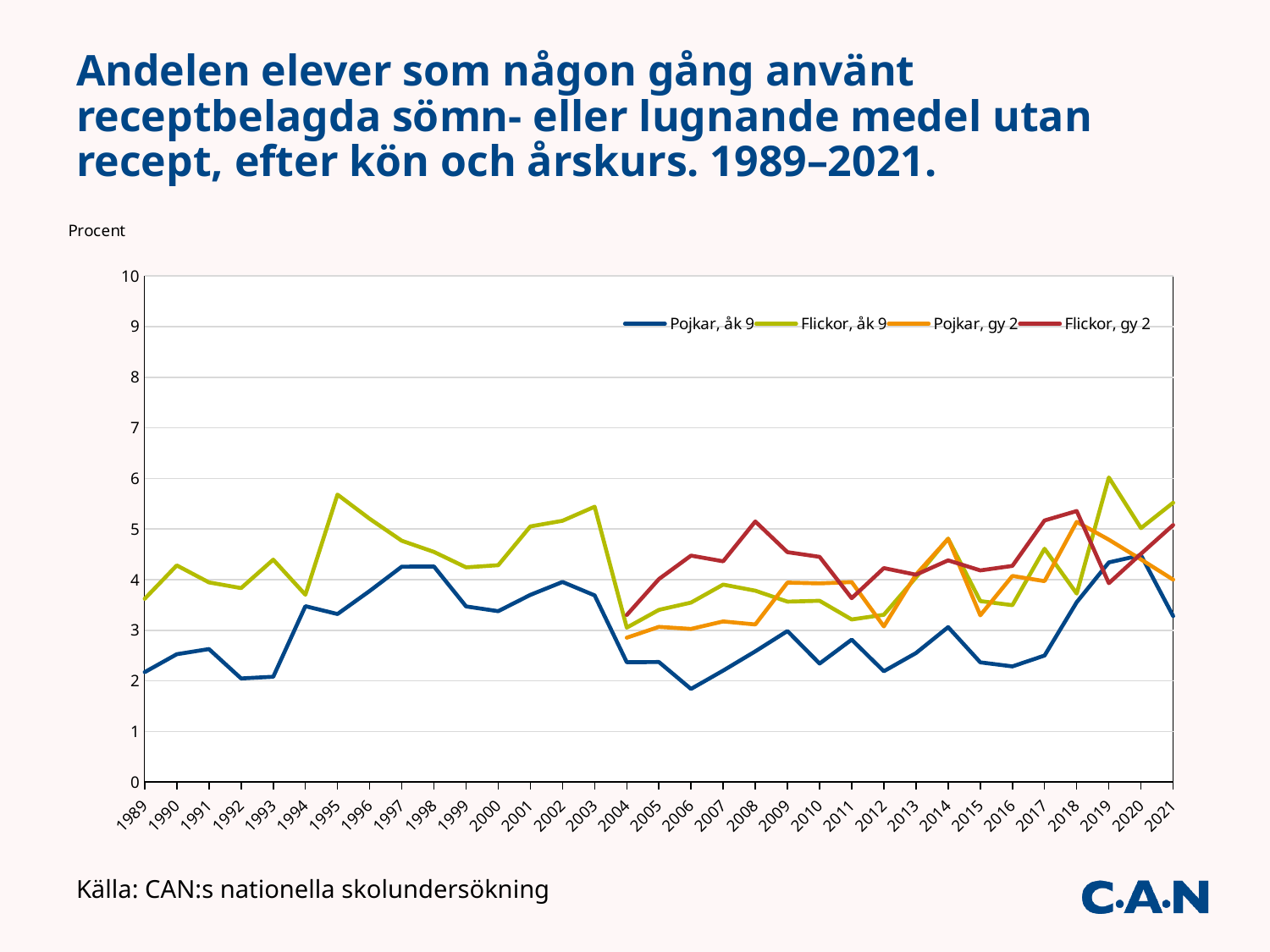
How many series does the legend list? 4 How many years are plotted along the x axis? 33 Does the Pojkar, åk 9 series rise or fall from 2020 to 2021? Fall In 2019, which is higher: Flickor, åk 9 or Pojkar, åk 9? Flickor, åk 9 What unit label is shown above the y axis? Procent Which series has the lowest value in 2006? Pojkar, åk 9 Is the value for Pojkar, åk 9 in 2006 greater or less than 2? less Is the value for Pojkar, gy 2 in 2014 greater or less than 4? greater Is the value for Flickor, åk 9 in 1995 greater or less than 5? greater In which year does the Pojkar, åk 9 series reach its lowest value? 2006 What kind of chart is shown on the slide? Line chart In which year does the Flickor, åk 9 series reach its highest value? 2019